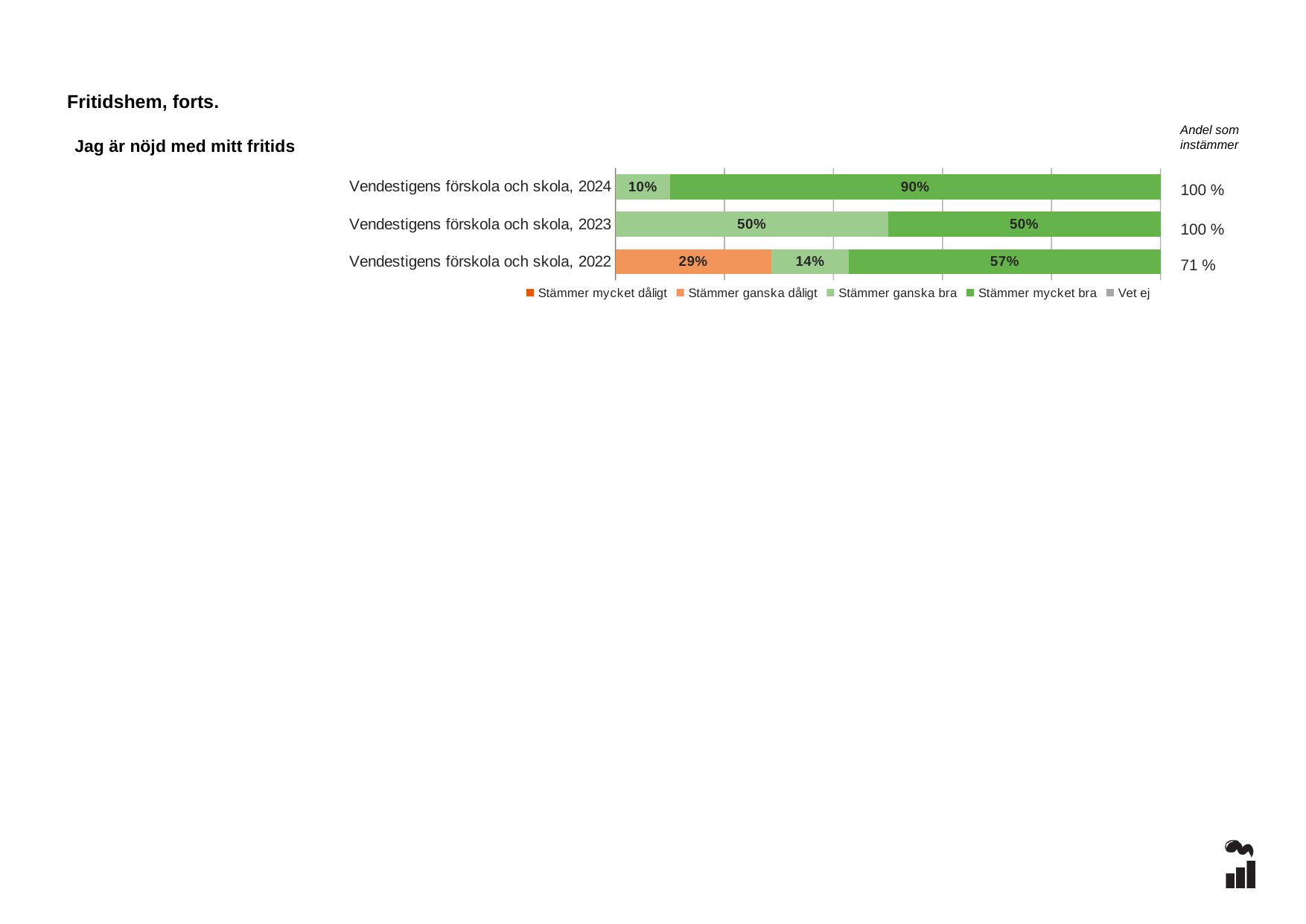
How many series does the legend list? 5 Which year has the lowest value for 'Stämmer ganska bra'? 2024 What kind of chart is shown on the slide? Stacked bar chart What is the difference between the 'Stämmer mycket bra' values for 2024 and 2022? 33 percentage points What is the value for 'Stämmer ganska bra' for Vendestigens förskola och skola, 2023? 50% What is the value for 'Stämmer ganska dåligt' for Vendestigens förskola och skola, 2022? 29% What is the value for 'Stämmer ganska bra' for Vendestigens förskola och skola, 2022? 14% How many bars (categories) are shown in the chart? 3 What is the value for 'Stämmer mycket bra' for Vendestigens förskola och skola, 2024? 90% Is the 'Stämmer mycket bra' value larger for 2023 or for 2022? 2022 What is the 'Andel som instämmer' value shown for Vendestigens förskola och skola, 2022? 71 % Which year has the highest value for 'Stämmer mycket bra'? 2024